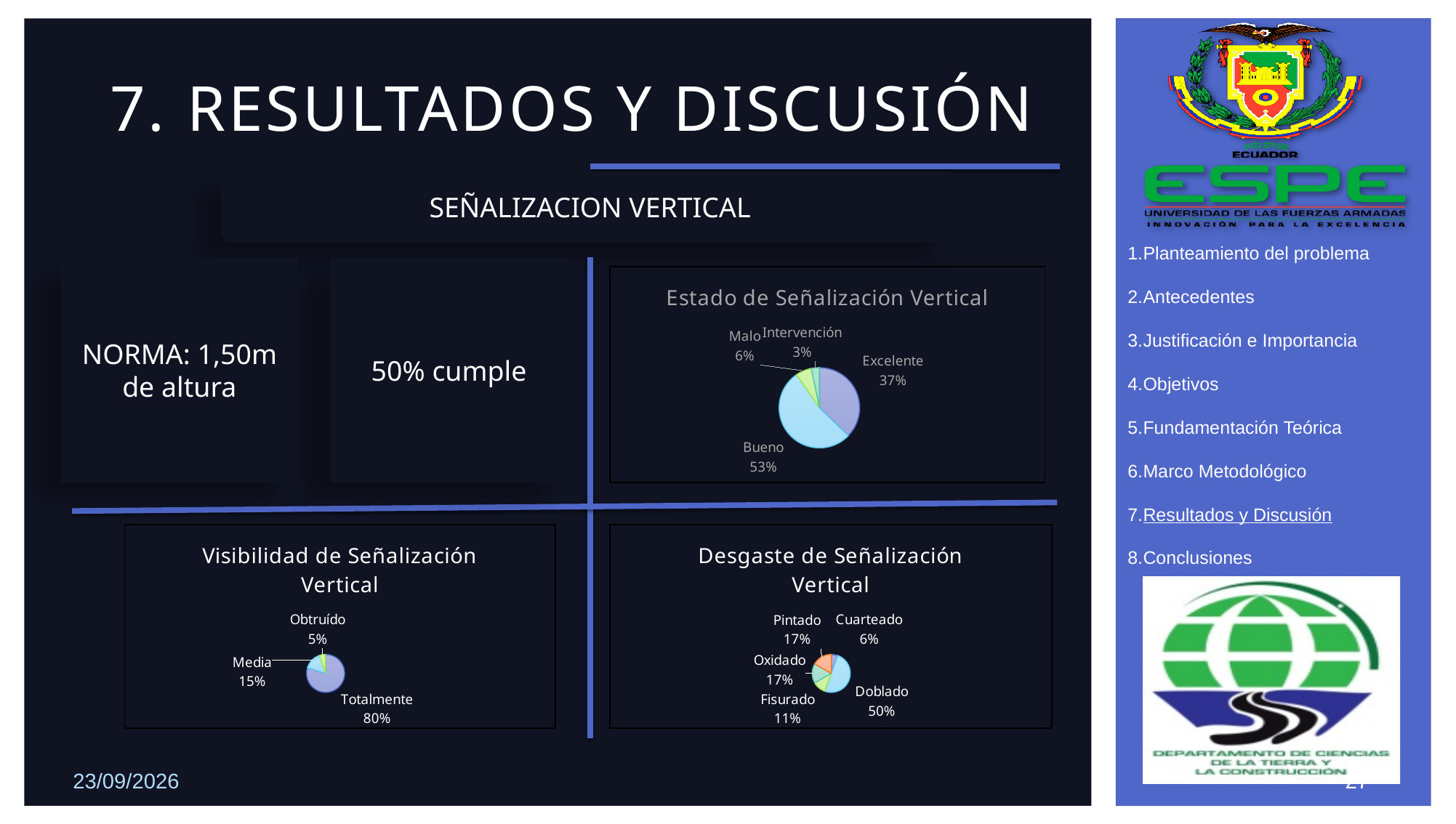
In the 'Estado de Señalización Vertical' chart, what is the difference between the Bueno and Excelente shares? 16% In the 'Desgaste de Señalización Vertical' chart, what share is labelled Doblado? 50% In the 'Desgaste de Señalización Vertical' chart, what is the difference between the Doblado and Pintado shares? 33% How many slices does the 'Estado de Señalización Vertical' pie chart have? 4 In the 'Desgaste de Señalización Vertical' chart, which is larger, Fisurado or Cuarteado? Fisurado In the 'Estado de Señalización Vertical' chart, what share is labelled Intervención? 3% In the 'Visibilidad de Señalización Vertical' chart, which category has the smallest share? Obtruído What type of chart is 'Visibilidad de Señalización Vertical'? Pie chart In the 'Estado de Señalización Vertical' chart, which category has the largest share? Bueno How many categories does the 'Desgaste de Señalización Vertical' pie chart show? 5 In the 'Estado de Señalización Vertical' chart, what share is labelled Bueno? 53% In the 'Visibilidad de Señalización Vertical' chart, what share is labelled Totalmente? 80%